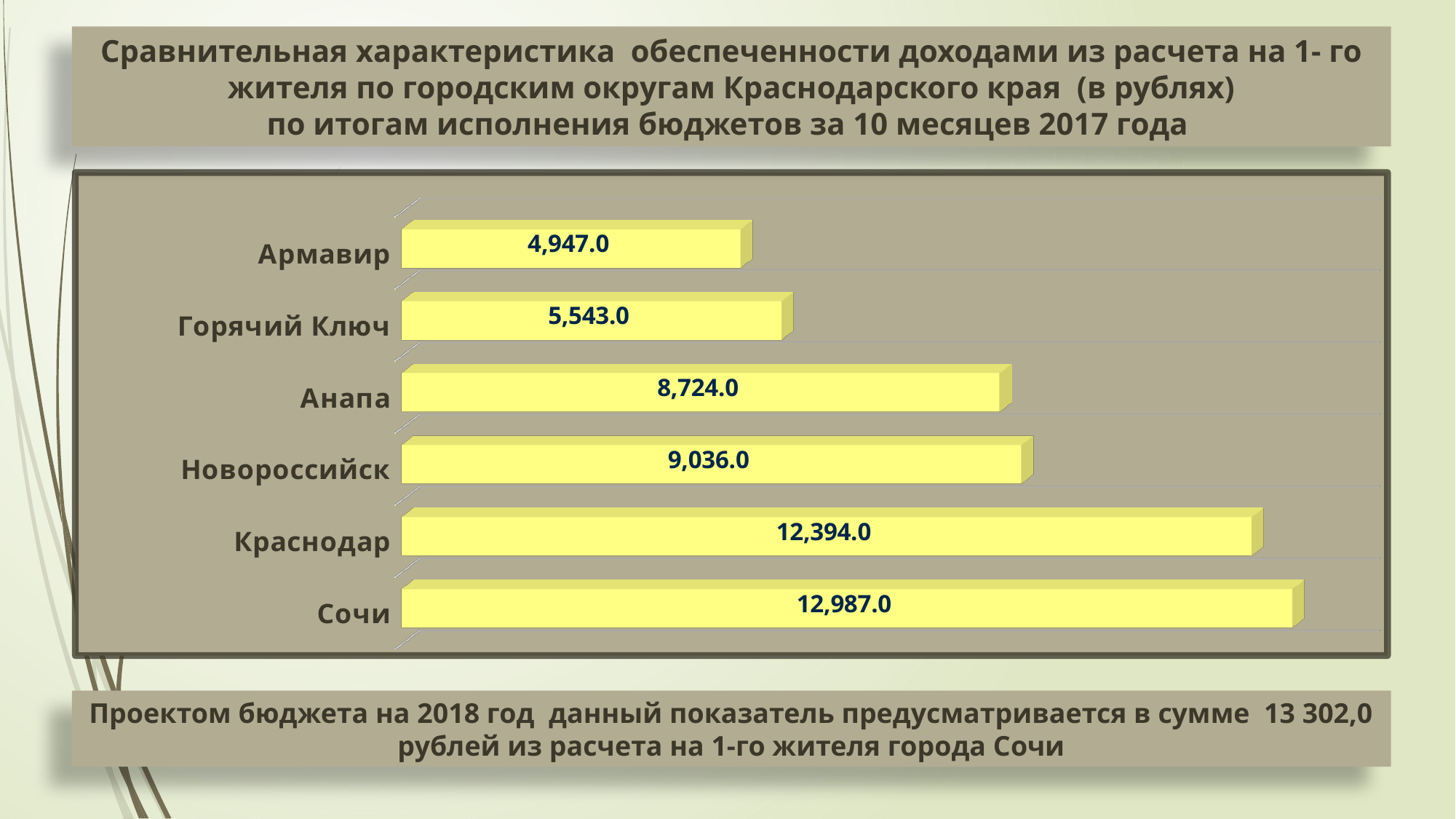
Which city has the highest value? Сочи What is the value for Армавир? 4,947.0 What colour are the bars in the chart? yellow What is the value for Горячий Ключ? 5,543.0 What is the difference between the values for Новороссийск and Анапа? 312.0 Which city has the lowest value? Армавир What kind of chart is shown on the slide? bar chart What is the difference between the values for Сочи and Краснодар? 593.0 What is the value for Сочи? 12,987.0 Which is larger, the value for Краснодар or the value for Новороссийск? Краснодар What is the value for Анапа? 8,724.0 How many cities are shown in the chart? 6